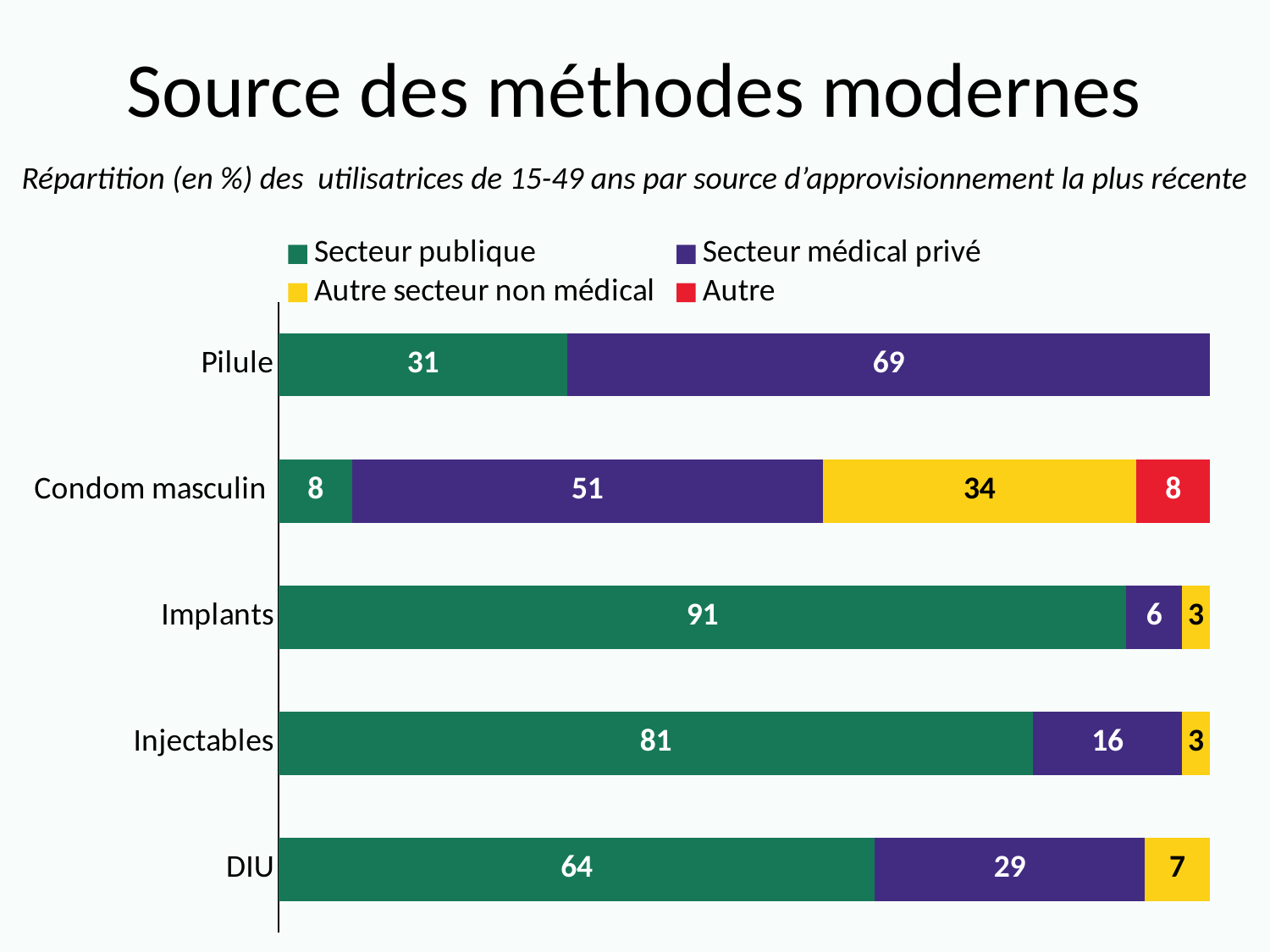
How many series does the legend list? 4 Which method has the lowest Secteur publique value? Condom masculin What is the total of the stacked bar for Condom masculin? 101 Which is larger: the Secteur médical privé value for Pilule or for DIU? Pilule What is the value for Secteur publique for Pilule? 31 What is the value for Autre for Condom masculin? 8 How many methods (categories) are shown in the chart? 5 Which method has the highest Secteur publique value? Implants What is the difference between the Secteur publique values for Implants and Injectables? 10 What is the value for Autre secteur non médical for DIU? 7 What kind of chart is shown on the slide? Stacked bar chart What is the value for Secteur médical privé for Condom masculin? 51